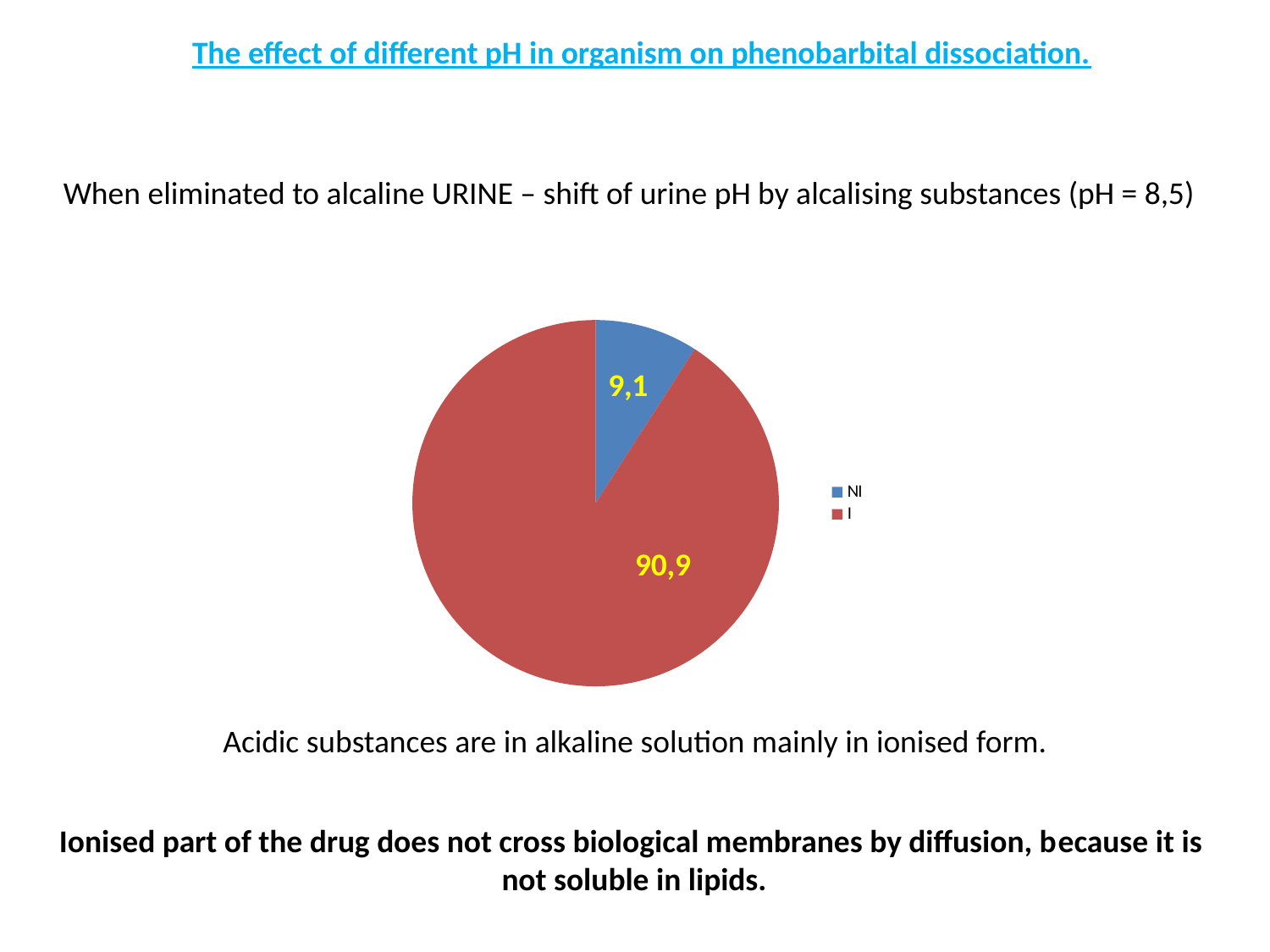
What is the value of the NI slice in the pie chart? 9,1 What is the value of the I slice in the pie chart? 90,9 Which is larger in the pie chart, NI or I? I What colour is the I slice in the pie chart? red Which slice of the pie chart is the smallest? NI Which slice of the pie chart is the largest? I How many entries does the legend of the pie chart list? 2 What colour is the NI slice in the pie chart? blue How many slices does the pie chart have? 2 What is the difference between the I and NI values in the pie chart? 81,8 What kind of chart is shown on the slide? pie chart